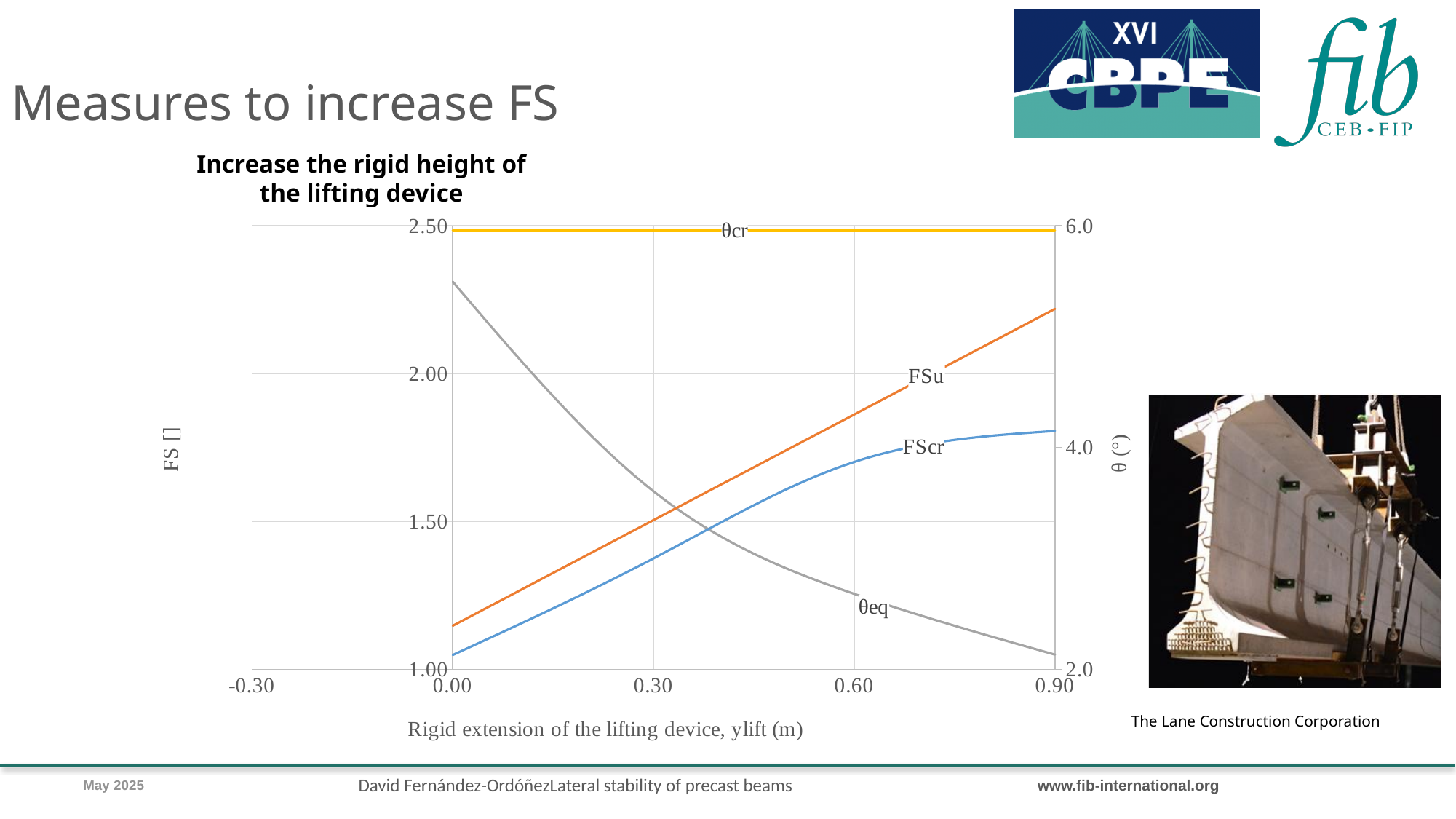
Does the FSu series rise or fall as ylift increases from 0.00 to 0.90? rises How many series are plotted on the chart? 4 At ylift = 0.90, which is larger, FSu or FScr? FSu Which of the FS series, FSu or FScr, reaches the highest value at ylift = 0.90? FSu What is the label of the horizontal axis? Rigid extension of the lifting device, ylift (m) Does the θeq series rise or fall as ylift increases from 0.00 to 0.90? falls Is the value of θeq at ylift = 0.00 greater or less than 4.0 on the right axis? greater What is the title of the chart? Increase the rigid height of the lifting device Is the value of FSu at ylift = 0.00 greater or less than 1.50? less Is the value of FScr at ylift = 0.90 greater or less than 2.00? less What kind of chart is shown on the slide? line chart